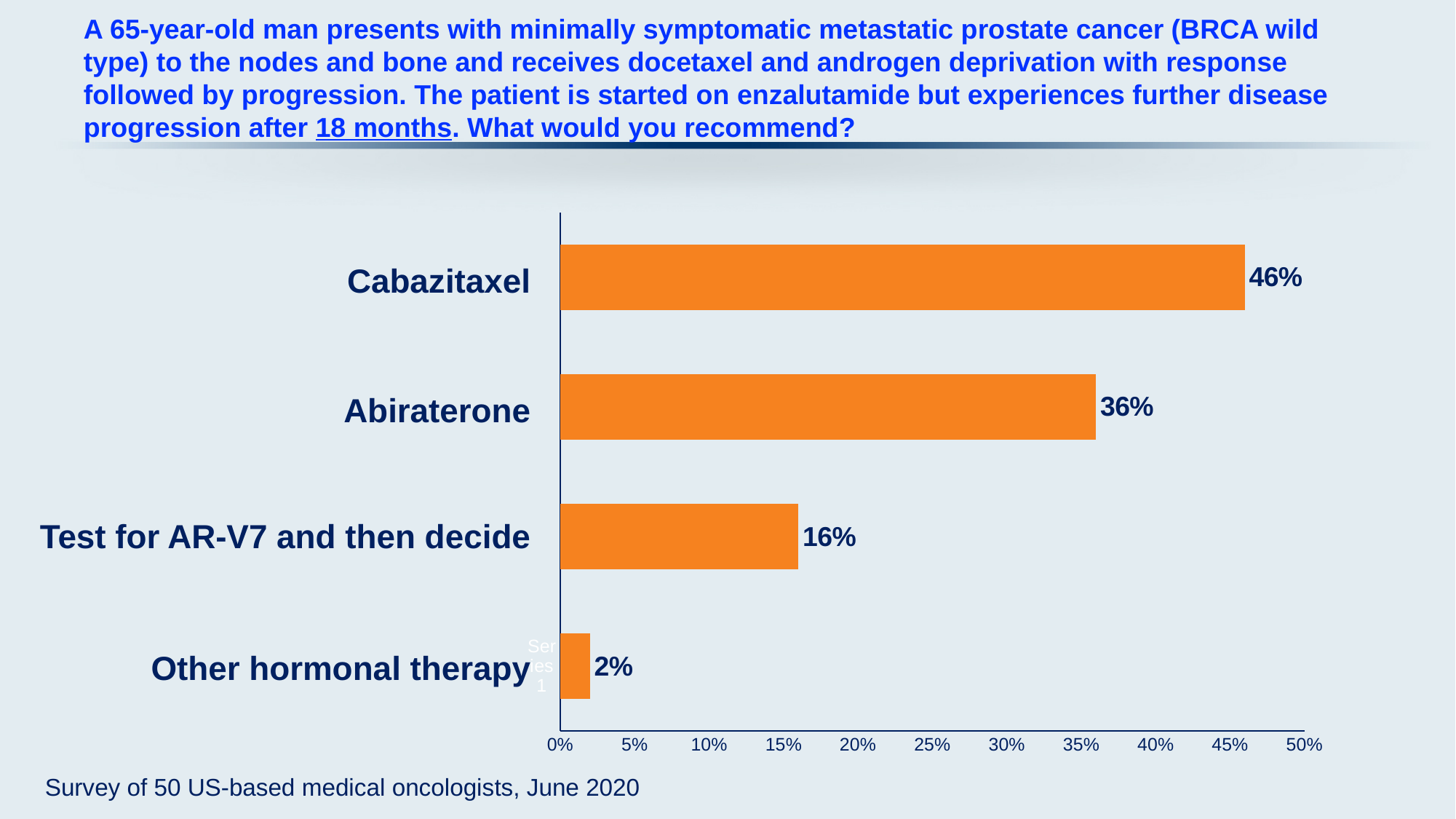
What percentage of respondents recommended Cabazitaxel? 46% What percentage of respondents recommended Abiraterone? 36% What percentage of respondents recommended 'Other hormonal therapy'? 2% Which option received the highest percentage of recommendations? Cabazitaxel What is the difference in percentage points between Abiraterone and 'Test for AR-V7 and then decide'? 20 What colour are the bars in the chart? Orange Which received a larger share of recommendations, Abiraterone or 'Test for AR-V7 and then decide'? Abiraterone What percentage of respondents chose 'Test for AR-V7 and then decide'? 16% What is the difference in percentage points between Cabazitaxel and Abiraterone? 10 What type of chart is shown on the slide? Bar chart How many answer options are shown in the chart? 4 Which option received the lowest percentage of recommendations? Other hormonal therapy